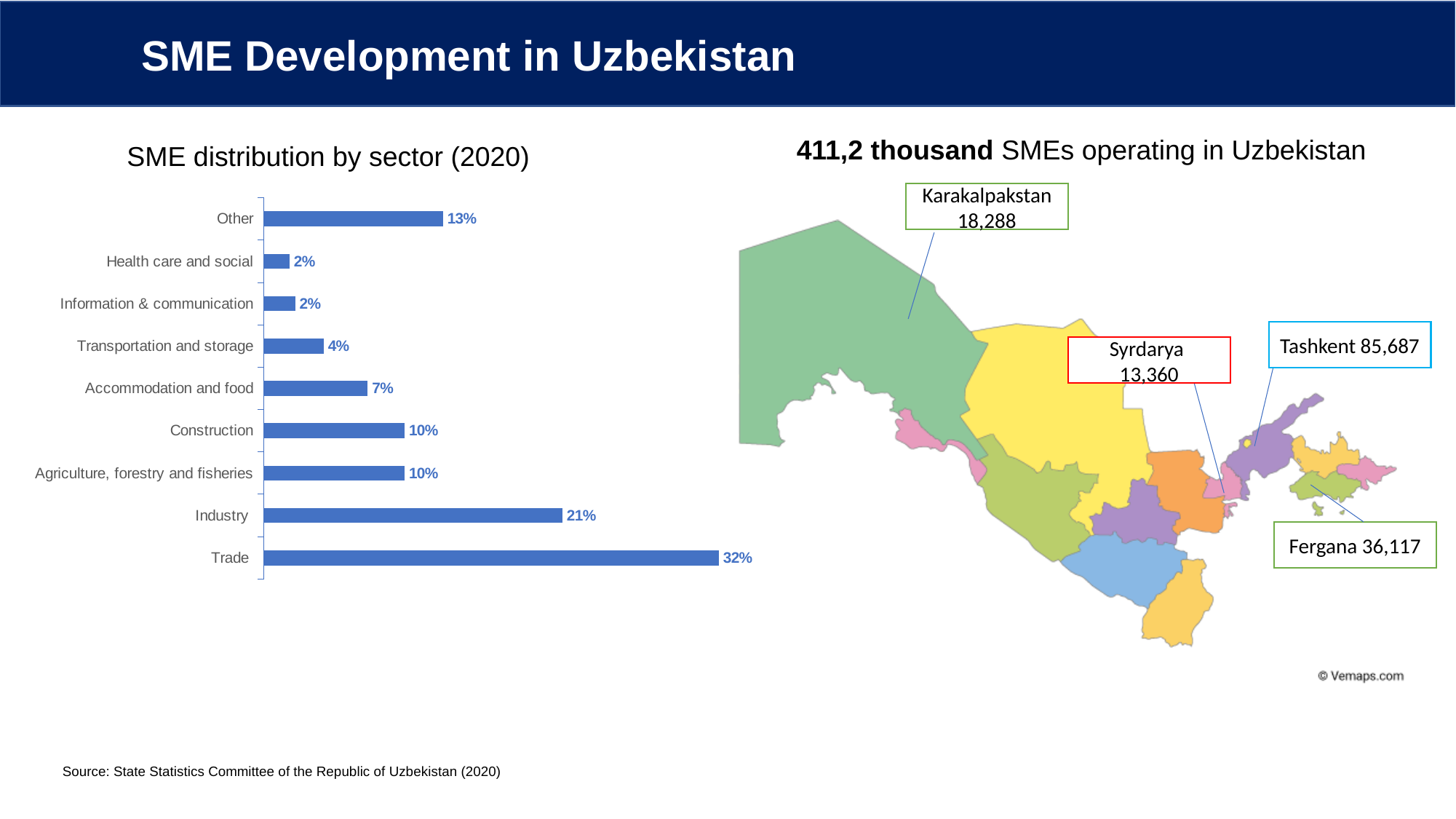
What is the value shown for Industry in the SME distribution by sector chart? 21% Which sector has the highest share of SMEs in the SME distribution by sector (2020) chart? Trade What share of SMEs is in Accommodation and food? 7% What is the title of the chart on the left side of the slide? SME distribution by sector (2020) What is the difference in percentage points between Trade and Industry in the SME distribution chart? 11 percentage points What percentage of SMEs are in the Trade sector according to the SME distribution by sector (2020) chart? 32% What value does the chart show for Health care and social? 2% What percentage is shown for Transportation and storage? 4% How many sectors are shown in the SME distribution by sector (2020) chart? 9 Which is larger in the SME distribution chart, Construction or Accommodation and food? Construction What is the difference between the Other category and Accommodation and food in the SME distribution chart? 6 percentage points What type of chart is used to show SME distribution by sector (2020)? Bar chart